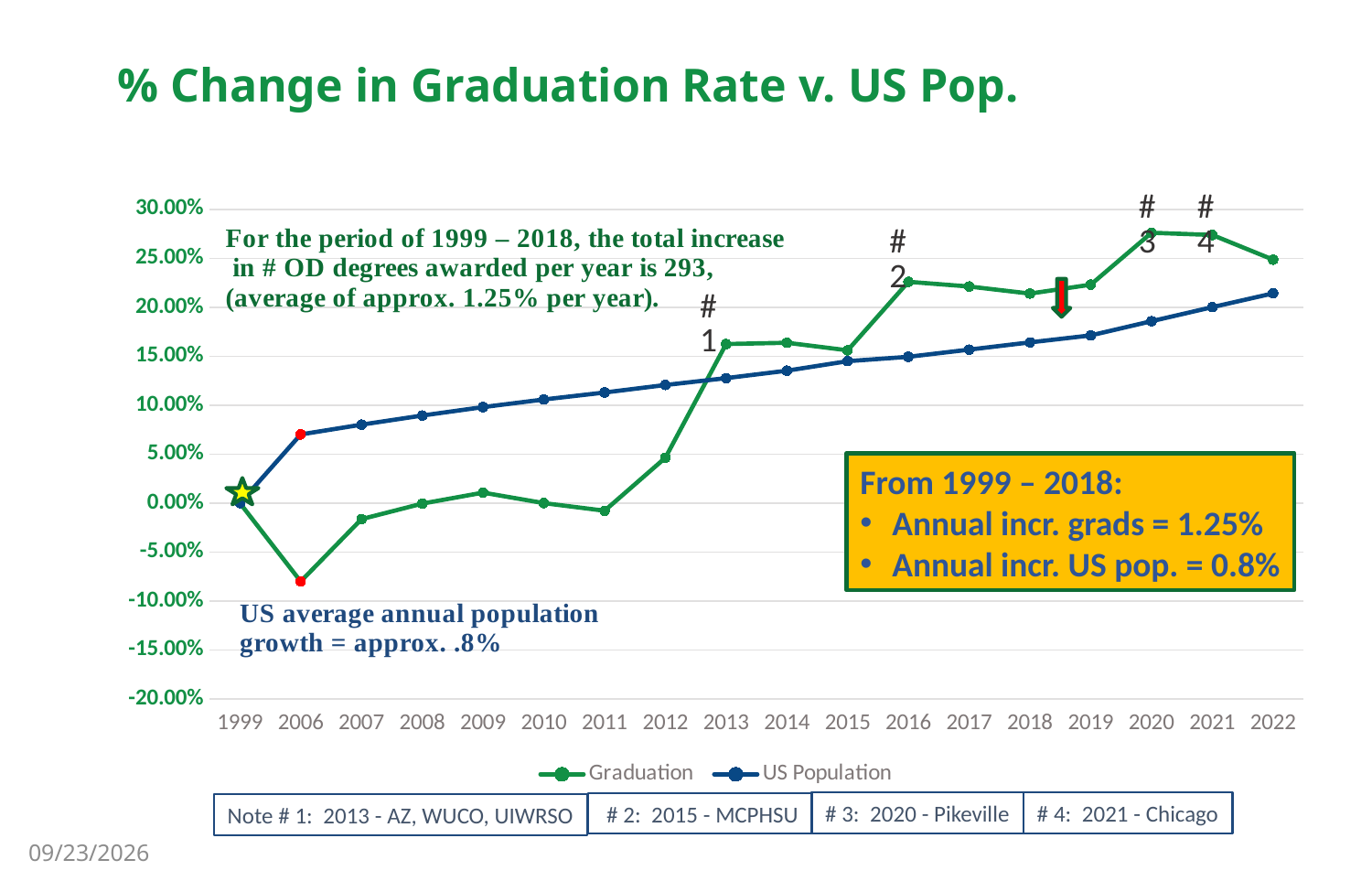
Does the US Population series rise or fall from 1999 to 2022? rise Is the Graduation value for 2006 greater or less than -5.00%? less In 2022, which series has the larger value, Graduation or US Population? Graduation How many series does the legend list? 2 Which year has the lowest value for the Graduation series? 2006 Is the US Population value for 2013 greater or less than 15.00%? less Is the Graduation value for 2022 greater or less than 20.00%? greater In 2012, which series has the larger value, Graduation or US Population? US Population How many years are shown along the x axis? 18 What is the title of the chart? % Change in Graduation Rate v. US Pop. What kind of chart is shown on the slide? line chart